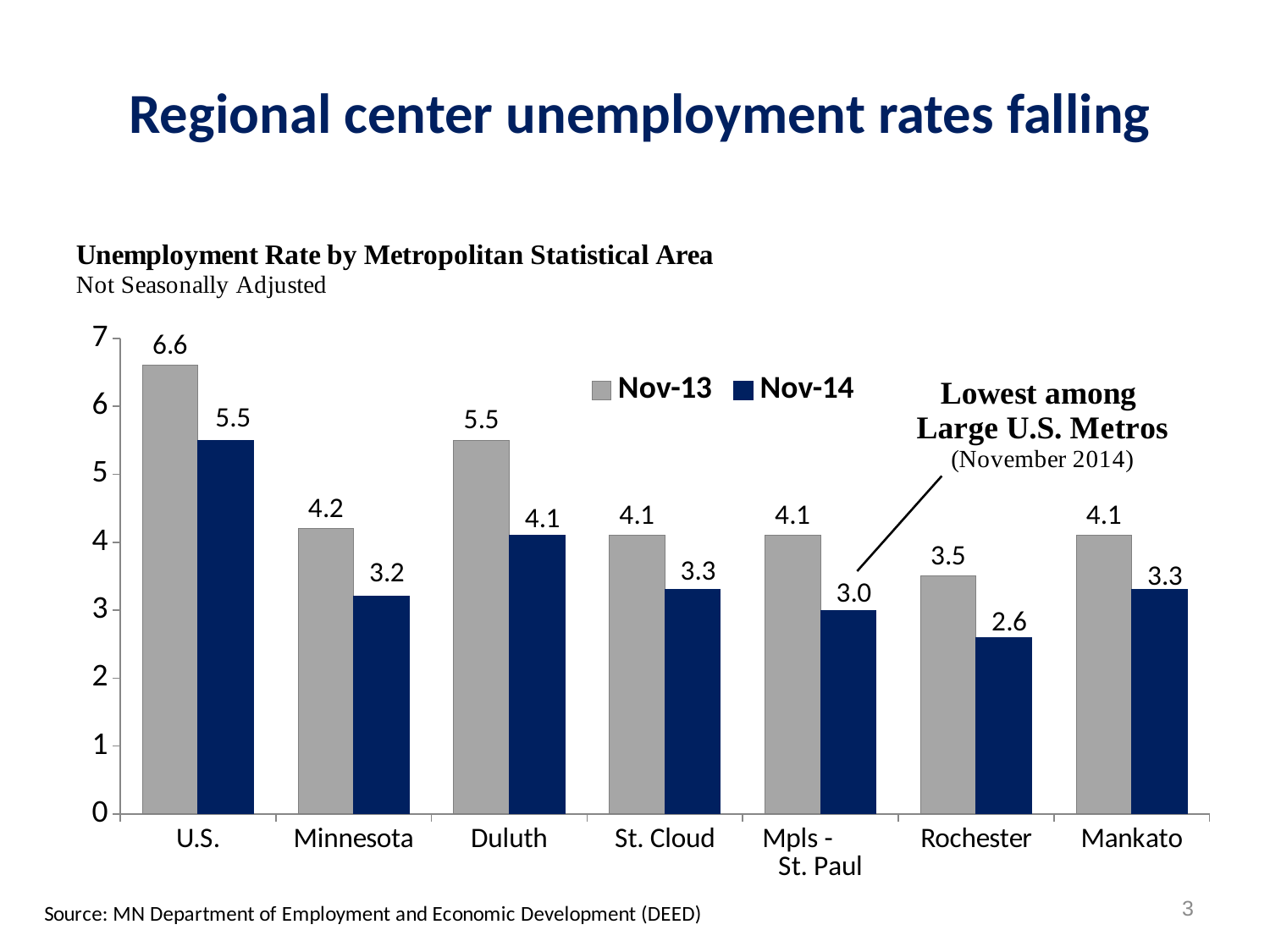
By how much did the U.S. unemployment rate fall from Nov-13 to Nov-14? 1.1 How many series does the legend list? 2 What was the Nov-13 unemployment rate for the U.S.? 6.6 Which is larger, the Nov-14 rate for Duluth or the Nov-14 rate for Mpls - St. Paul? Duluth Which area had the lowest Nov-14 unemployment rate? Rochester What kind of chart is shown on the slide? Bar chart Which area had the highest Nov-13 unemployment rate? U.S. What was the Nov-14 unemployment rate for Minnesota? 3.2 What was the Nov-14 unemployment rate for Rochester? 2.6 Which area is annotated as having the lowest unemployment rate among large U.S. metros in November 2014? Mpls - St. Paul What is the difference between the Nov-13 and Nov-14 unemployment rates for Duluth? 1.4 How many metropolitan areas or regions are shown on the x axis? 7